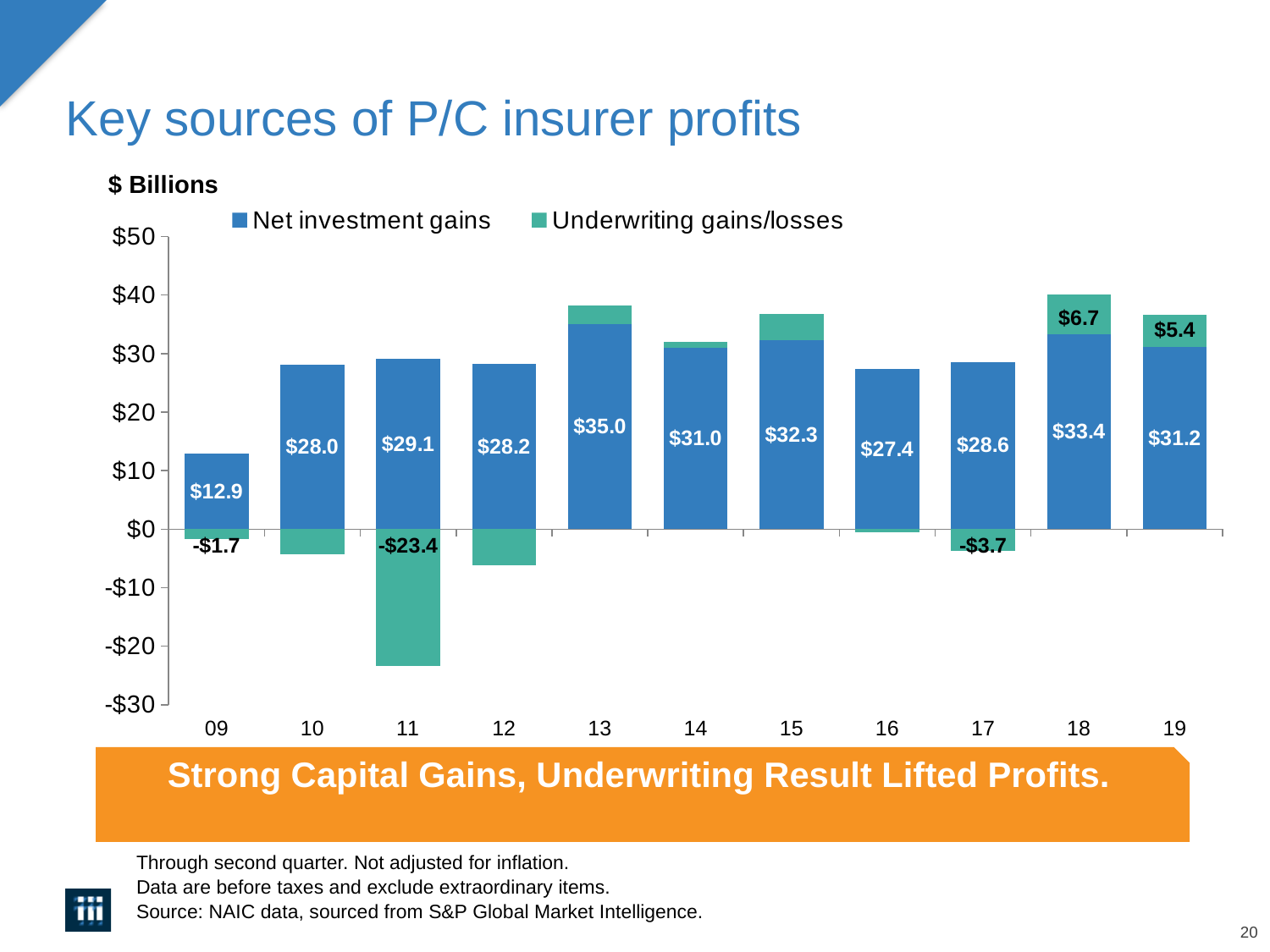
What kind of chart is shown on the slide? Stacked bar chart Which year has the highest Net investment gains? 13 Which year has the lowest Net investment gains? 09 What is the value of Underwriting gains/losses for 11? -$23.4 How many years are shown on the x axis? 11 Which year has larger Net investment gains, 14 or 15? 15 What is the value of Net investment gains for 13? $35.0 What is the difference in Net investment gains between 18 and 19? $2.2 What is the value of Underwriting gains/losses for 17? -$3.7 What is the difference in Net investment gains between 13 and 09? $22.1 How many series does the legend list? 2 Is the value of Underwriting gains/losses for 12 greater or less than $0? less